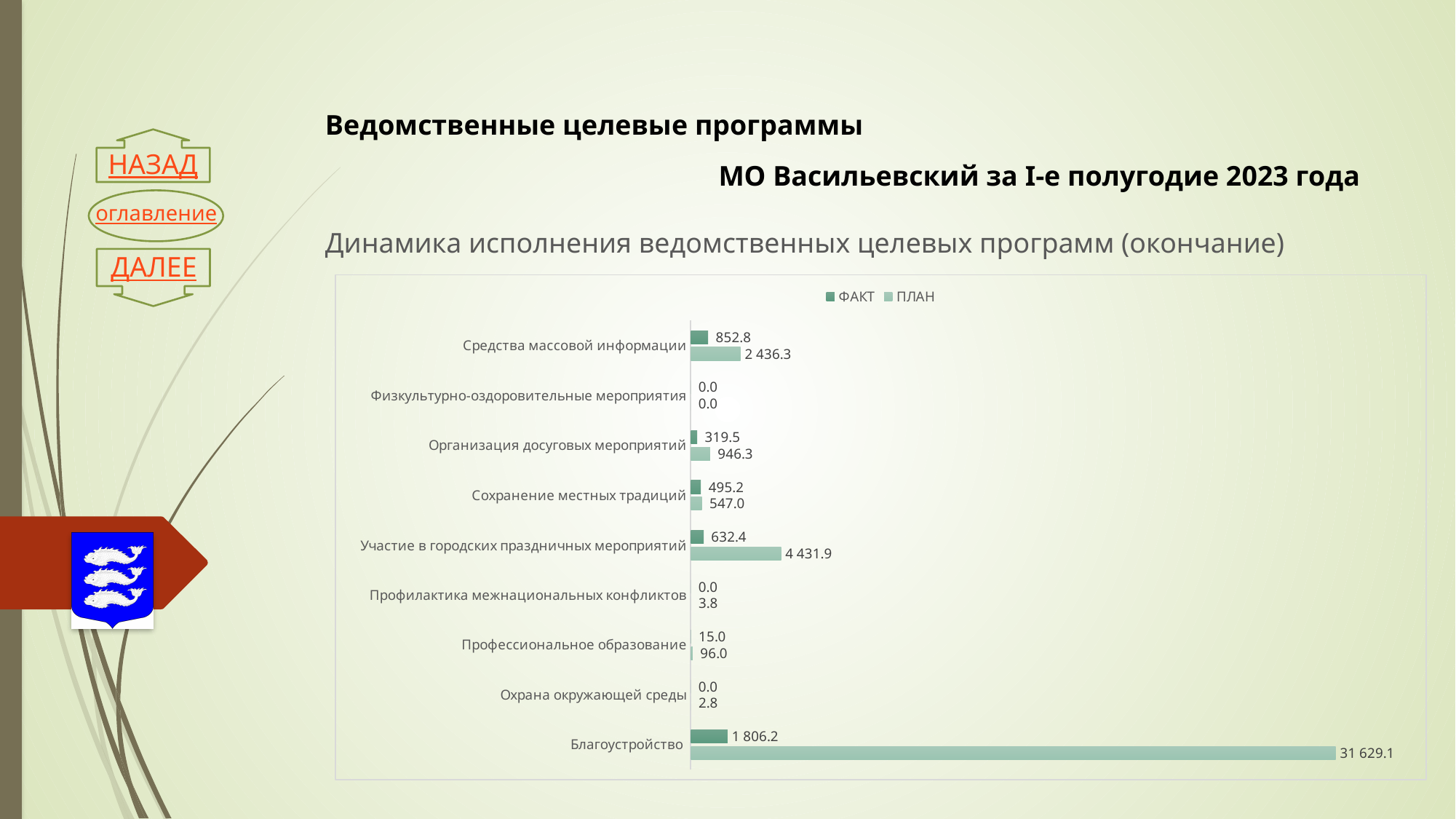
What is the ФАКТ value for Профессиональное образование? 15.0 What is the ПЛАН value for Участие в городских праздничных мероприятий? 4 431.9 How many categories are shown in the chart? 9 What kind of chart is shown on the slide? Bar chart Which category has the lowest non-zero ПЛАН value? Охрана окружающей среды How many series does the legend list? 2 What is the ПЛАН value for Средства массовой информации? 2 436.3 What is the ФАКТ value for Благоустройство? 1 806.2 Which category has the highest ПЛАН value? Благоустройство Which is larger: the ФАКТ value for Средства массовой информации or the ФАКТ value for Участие в городских праздничных мероприятий? Средства массовой информации What is the difference between the ПЛАН and ФАКТ values for Сохранение местных традиций? 51.8 What is the difference between the ПЛАН and ФАКТ values for Благоустройство? 29 822.9